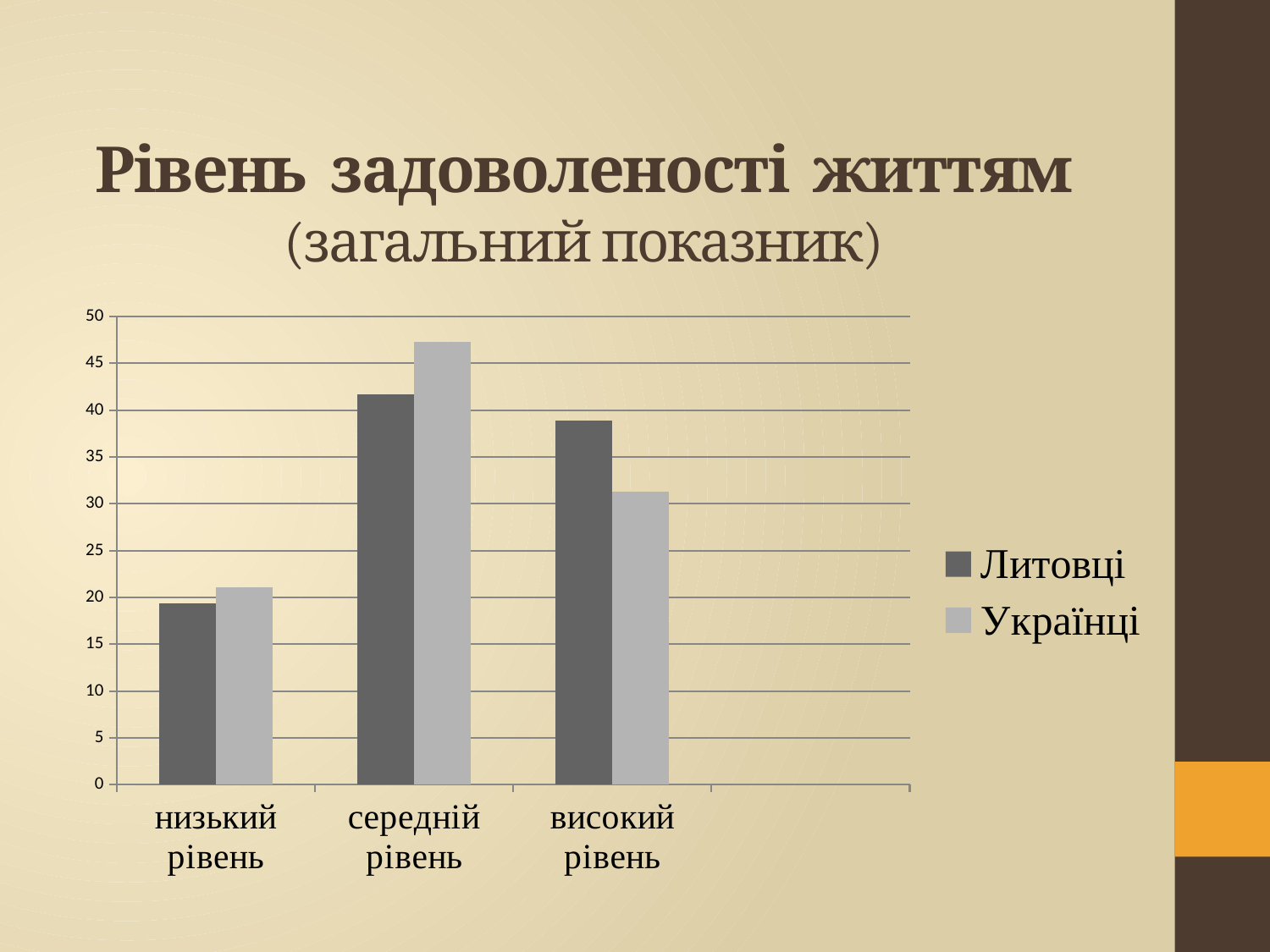
Which category has the lowest value for Литовці? низький рівень For високий рівень, which series has the larger value, Литовці or Українці? Литовці Is the value for Українці at високий рівень greater or less than 30? greater For середній рівень, which series has the larger value, Литовці or Українці? Українці How many series does the legend list? 2 Is the value for Литовці at низький рівень greater or less than 20? less Is the value for Українці at середній рівень greater or less than 45? greater Which category has the highest value for Українці? середній рівень Which category has the highest value for Литовці? середній рівень Which series is shown in the darker grey bars? Литовці What kind of chart is shown on the slide? bar chart How many categories are shown on the x axis? 3